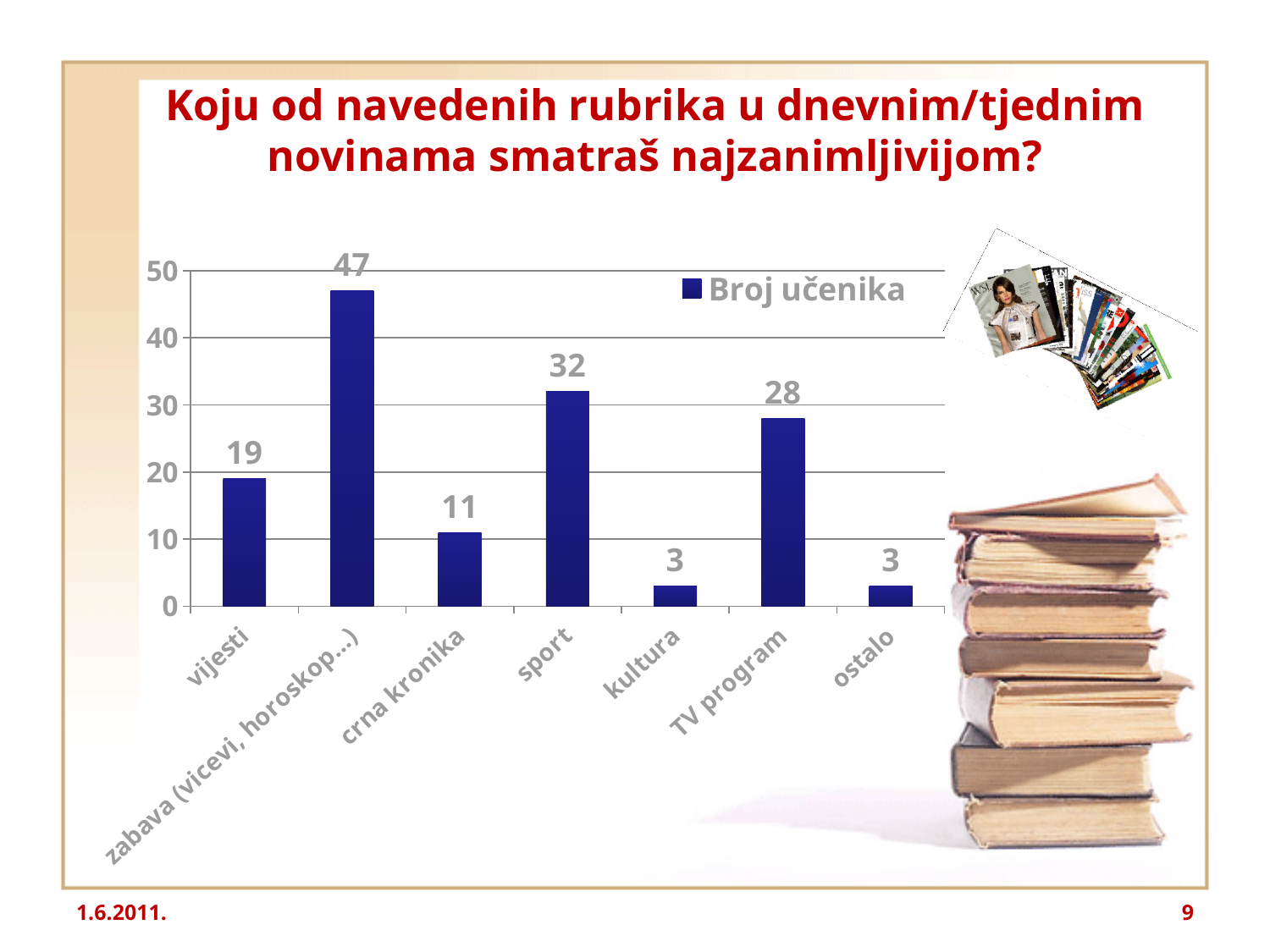
Which is larger, the value for sport or the value for TV program? sport How many series does the legend list? 1 Is the value for vijesti greater or less than 20? less What kind of chart is shown on the slide? bar chart How many categories are shown on the x axis? 7 What is the value for crna kronika? 11 What is the value for TV program? 28 Which category has the highest value? zabava (vicevi, horoskop...) What is the difference between the values for zabava (vicevi, horoskop...) and vijesti? 28 What is the difference between the values for sport and kultura? 29 What is the value for sport? 32 What is the name of the series shown in the legend? Broj učenika